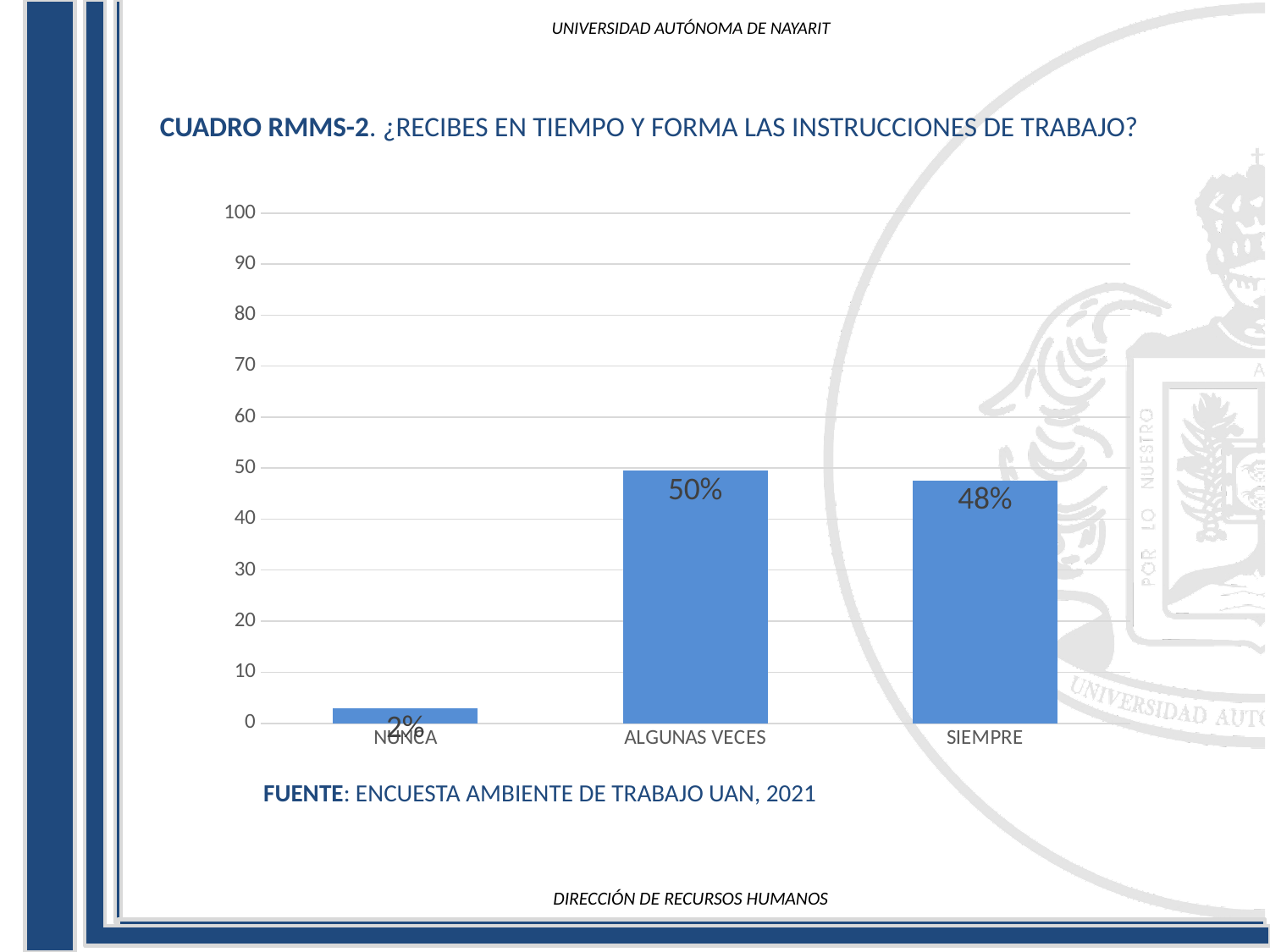
What kind of chart is shown on the slide? Bar chart Which is larger, the value for ALGUNAS VECES or the value for SIEMPRE? ALGUNAS VECES What source is cited below the chart? ENCUESTA AMBIENTE DE TRABAJO UAN, 2021 What is the value for ALGUNAS VECES? 50% Which category has the lowest value? NUNCA How many categories are shown on the x axis? 3 What is the value for NUNCA? 2% What is the value for SIEMPRE? 48% Which category has the highest value? ALGUNAS VECES What is the difference between the values for ALGUNAS VECES and SIEMPRE? 2% What is the difference between the values for SIEMPRE and NUNCA? 46% Is the value for SIEMPRE greater or less than 40? greater